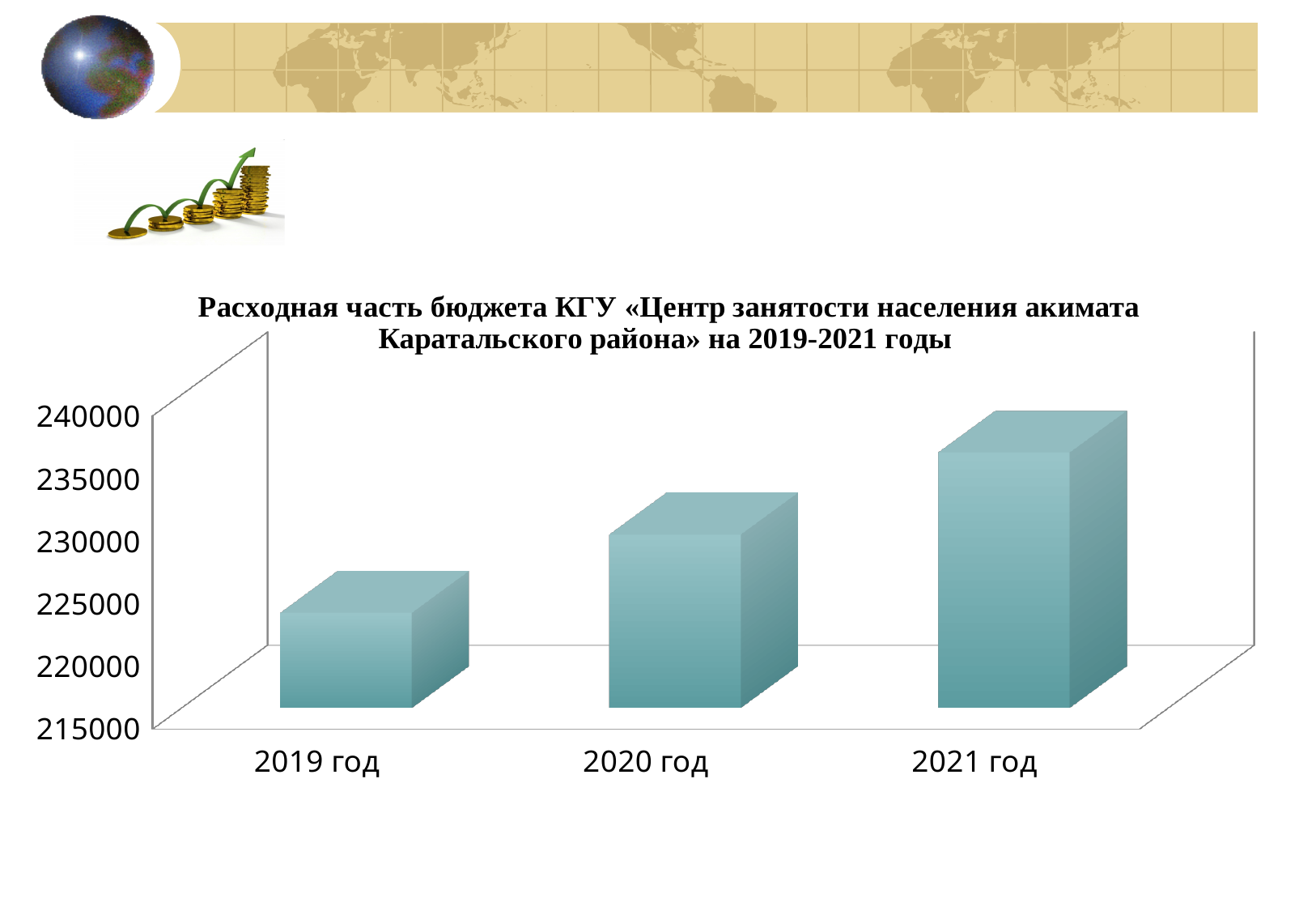
What kind of chart is shown on the slide? bar chart Do the values rise or fall from 2019 to 2021 along the x axis? rise Is the value for 2021 год greater or less than 230000? greater What is the title of the chart? Расходная часть бюджета КГУ «Центр занятости населения акимата Каратальского района» на 2019-2021 годы Which is larger, the value for 2020 год or the value for 2019 год? 2020 год Which year has the highest budget expenditure in the chart? 2021 год What is the highest value shown on the vertical axis of the chart? 240000 Is the value for 2019 год greater or less than 230000? less Which year has the lowest budget expenditure in the chart? 2019 год Which is larger, the value for 2021 год or the value for 2019 год? 2021 год Is the value for 2020 год greater or less than 225000? greater How many years (categories) are plotted in the chart? 3